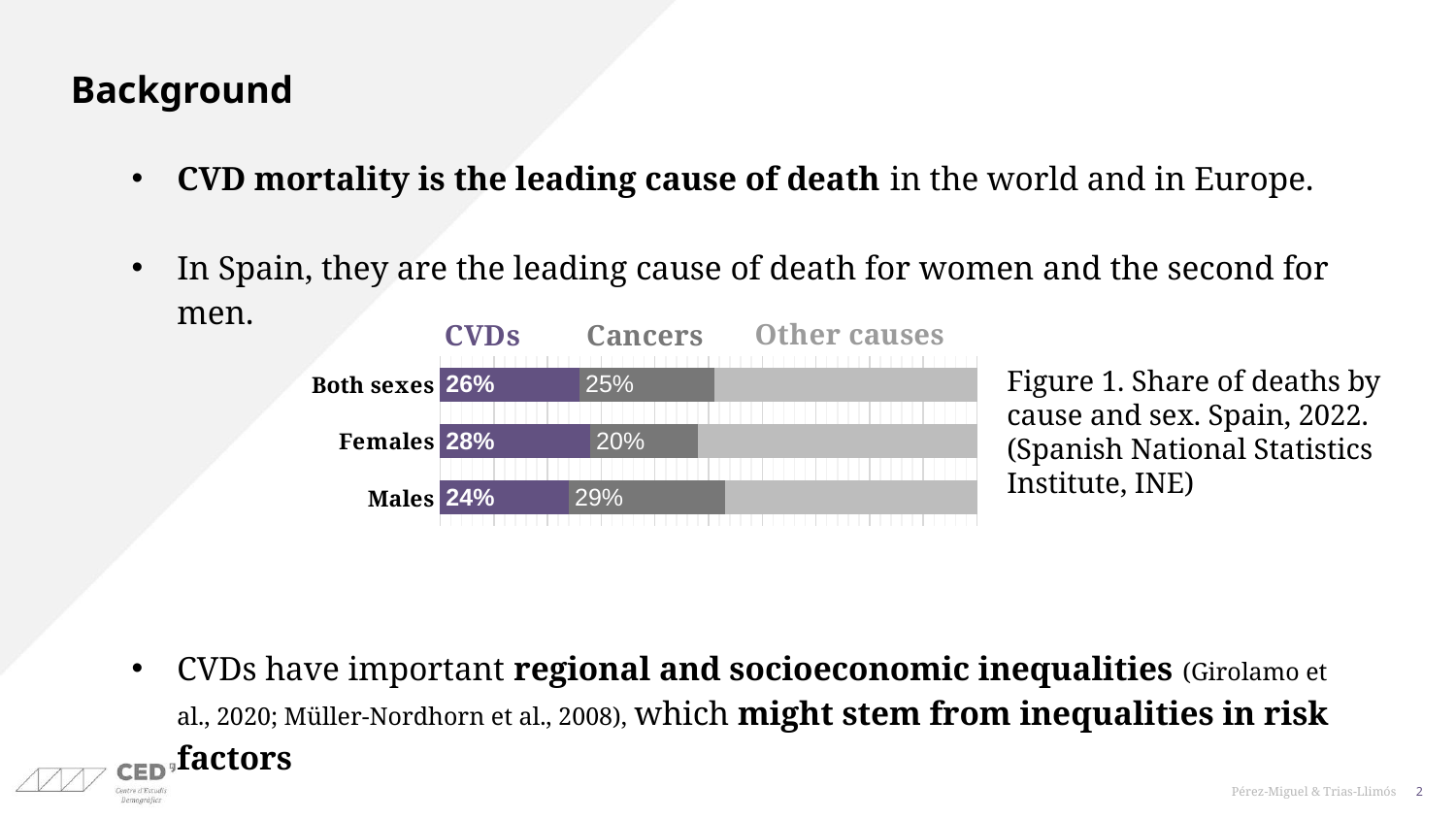
What is the CVDs share for Both sexes? 26% Which category has the lowest Cancers share? Females How many series does the chart's legend list? 3 What is the CVDs share for Females? 28% What is the Cancers share for Males? 29% What is the Cancers share for Females? 20% What is the difference between the CVDs share for Females and for Males? 4% For Males, which is larger: the CVDs share or the Cancers share? Cancers Which category has the highest CVDs share? Females What kind of chart is shown on the slide? Stacked bar chart How many categories are shown on the chart? 3 Which series is shown in purple? CVDs